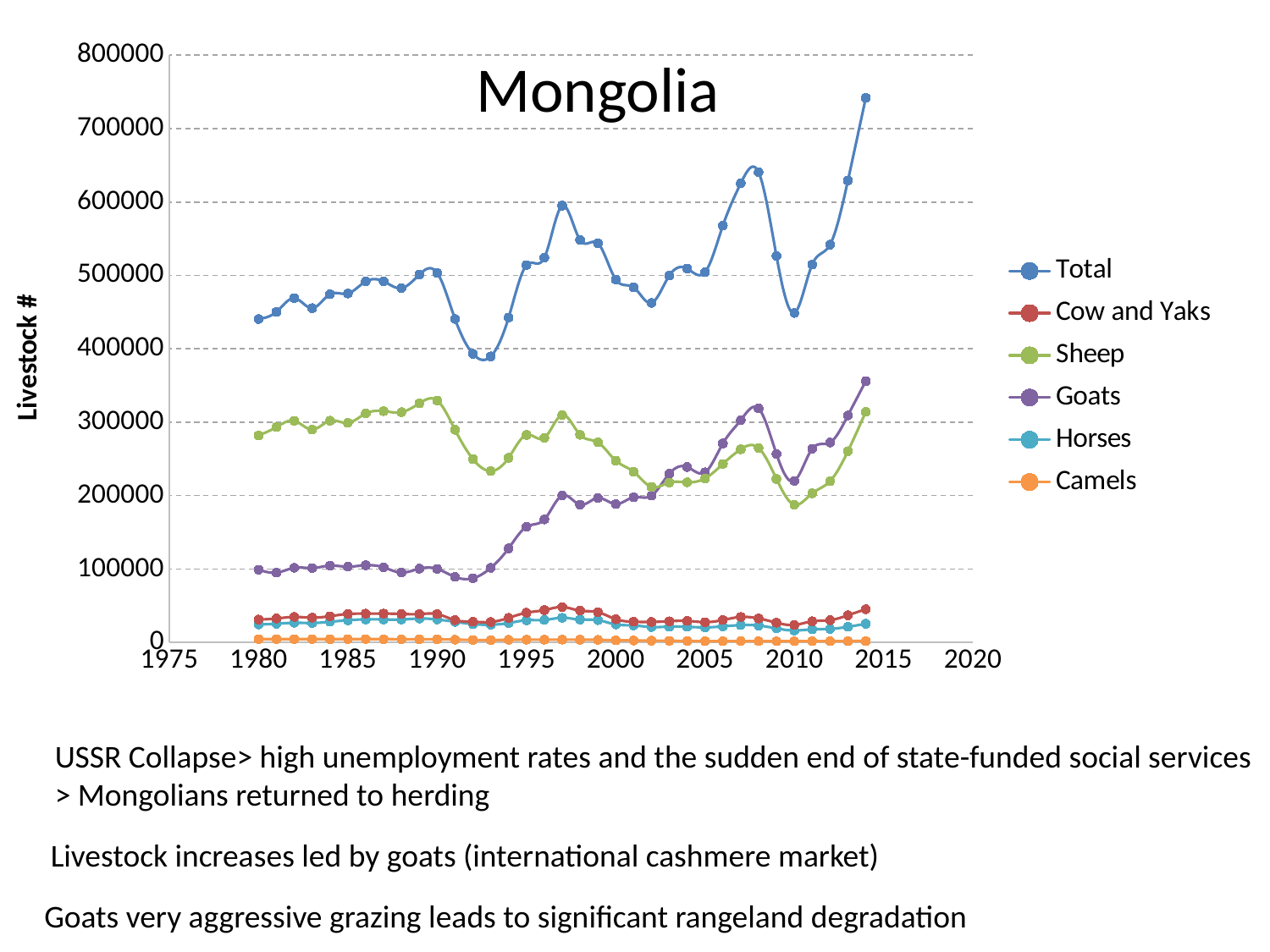
Which series has the highest values throughout the chart? Total Which series has the lowest values throughout the chart? Camels Is the value for Total in 2014 greater or less than 700000? greater What kind of chart is shown on the slide? line chart How many series does the legend list? 6 What is the label on the vertical axis? Livestock # In 1980, which is larger, Sheep or Goats? Sheep Is the value for Goats in 1980 greater or less than 200000? less What is the title of the chart? Mongolia Is the value for Total in 2010 greater or less than 500000? less In 2014, which is larger, Goats or Sheep? Goats Do the values for Goats generally rise or fall from 1980 to 2014? rise